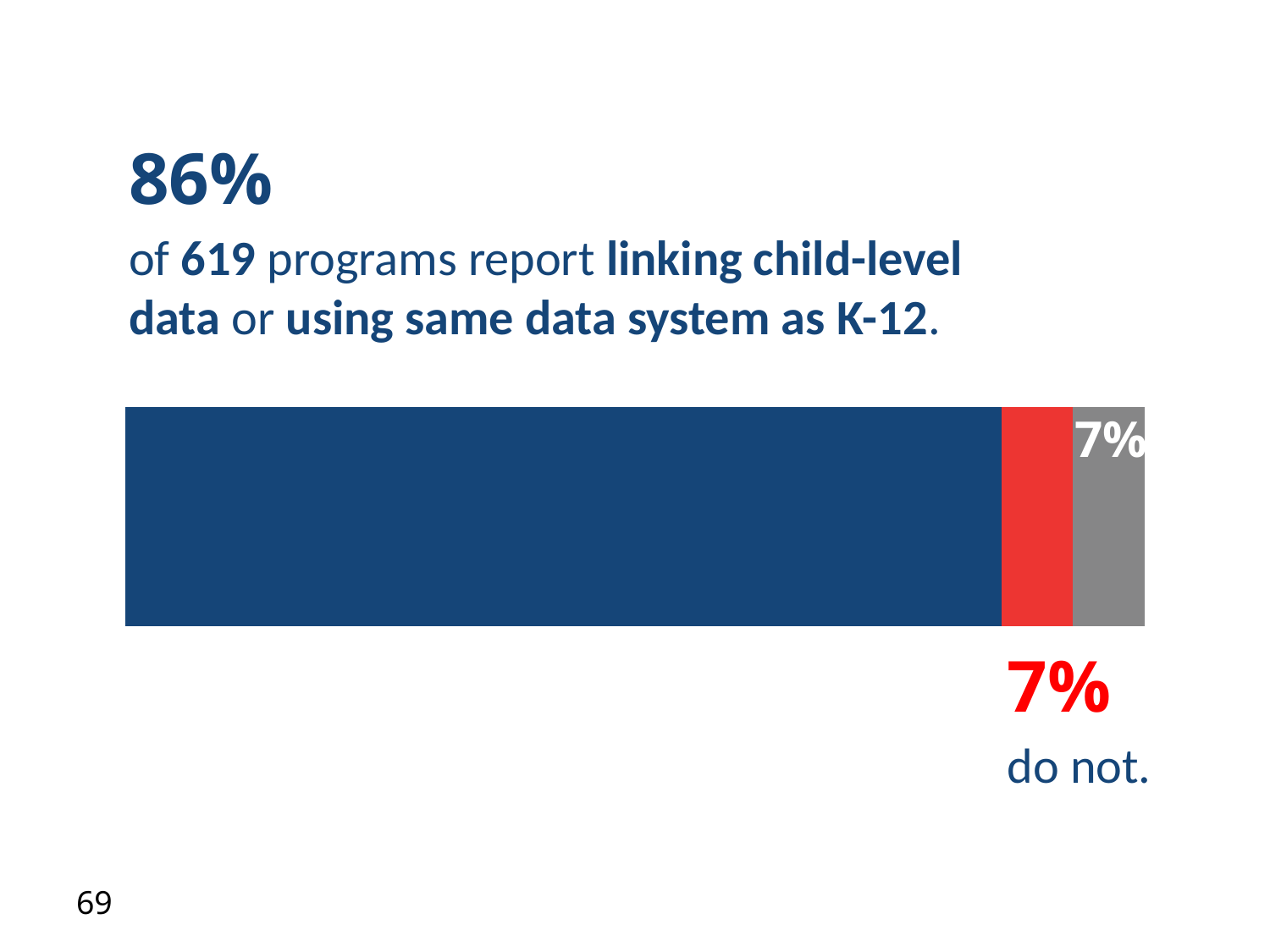
Which colour segment of the bar is the largest? blue What is the total of the three segments of the stacked bar (86%, 7% and 7%)? 100% What value is printed on the gray segment of the bar? 7% How many programs does the slide say were surveyed? 619 How many segments make up the stacked bar on the slide? 3 Is the blue segment or the red segment of the bar larger? blue What percentage of the 619 programs report linking child-level data or using the same data system as K-12? 86% What percentage of programs do not link child-level data or use the same data system as K-12? 7% What kind of chart is shown on the slide? bar chart What colour is the segment labelled 'do not' on the slide? red What is the difference between the 86% segment and the 7% 'do not' segment? 79%